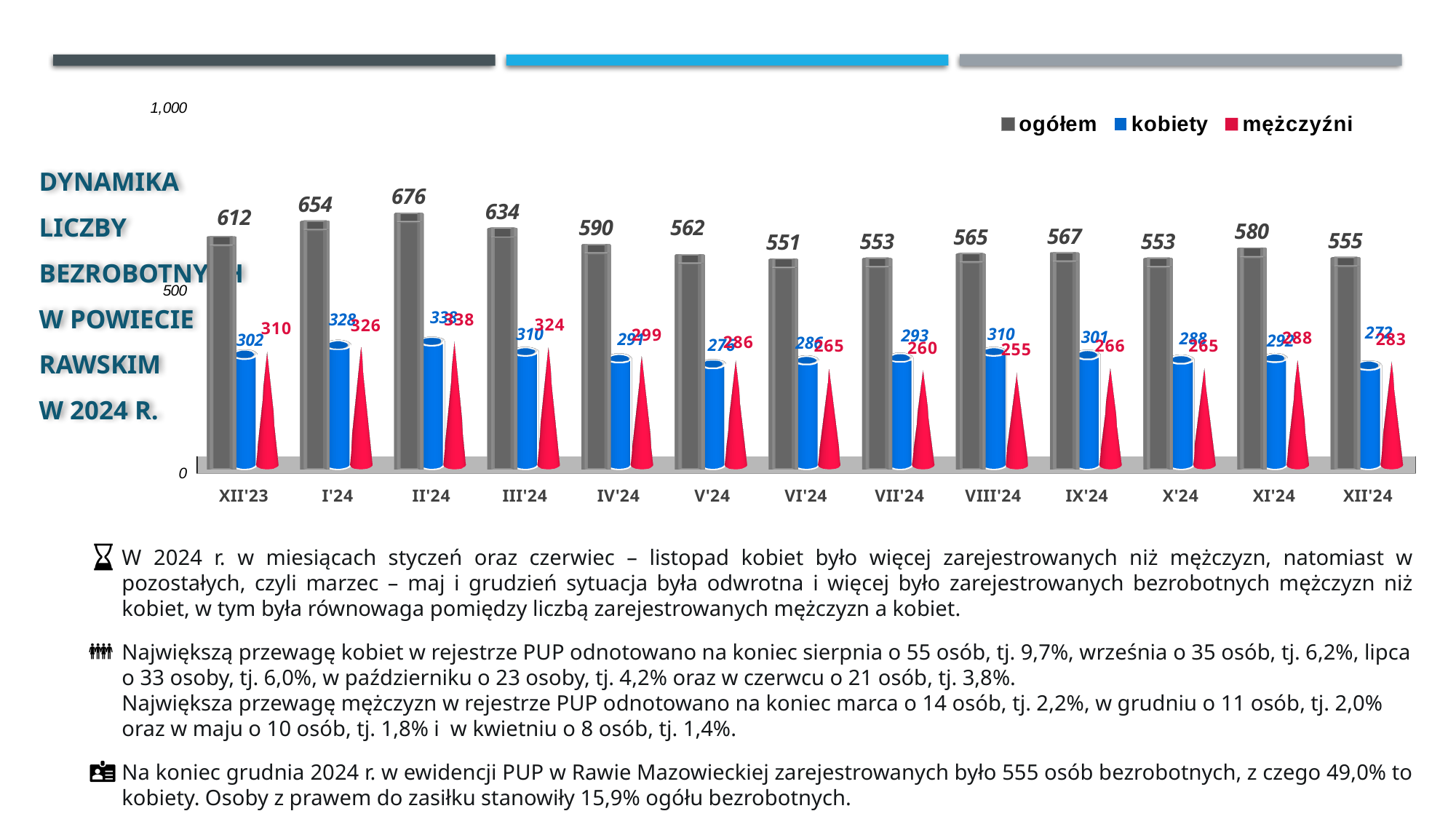
In which month is the ogółem value lowest? VI'24 How many series does the legend list? 3 What is the value of mężczyźni for VII'24? 260 What kind of chart is shown on the slide? bar chart How many months are shown on the x axis? 13 What is the value of kobiety for VIII'24? 310 What is the value of ogółem for II'24? 676 For VIII'24, which is larger: kobiety or mężczyźni? kobiety Is the ogółem value for XII'23 greater or less than 500? greater In which month is the ogółem value highest? II'24 What is the value of ogółem for XII'24? 555 What is the difference between the ogółem values for II'24 and XII'23? 64